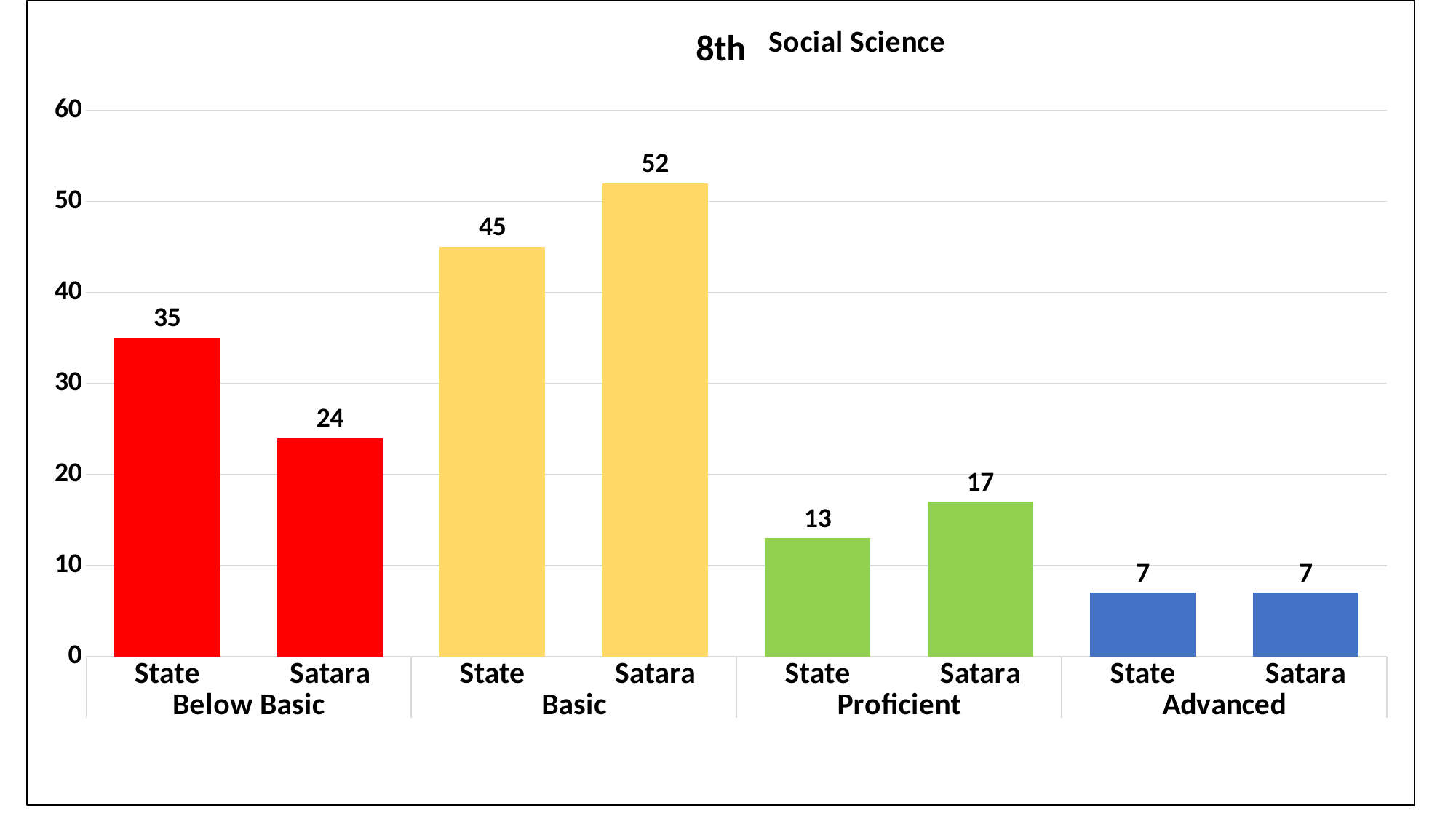
What is the difference between the State and Satara values for Below Basic? 11 Which is larger for Proficient, the State value or the Satara value? Satara What is the difference between the Satara and State values for Basic? 7 What is the State value for Below Basic? 35 What is the State value for Advanced? 7 What is the Satara value for Proficient? 17 What is the title of the chart? 8th Social Science Which bar has the highest value on the chart? Satara, Basic What is the Satara value for Basic? 52 What kind of chart is shown on the slide? bar chart Is the State value for Basic greater or less than 40? greater How many performance level groups are shown on the x axis? 4